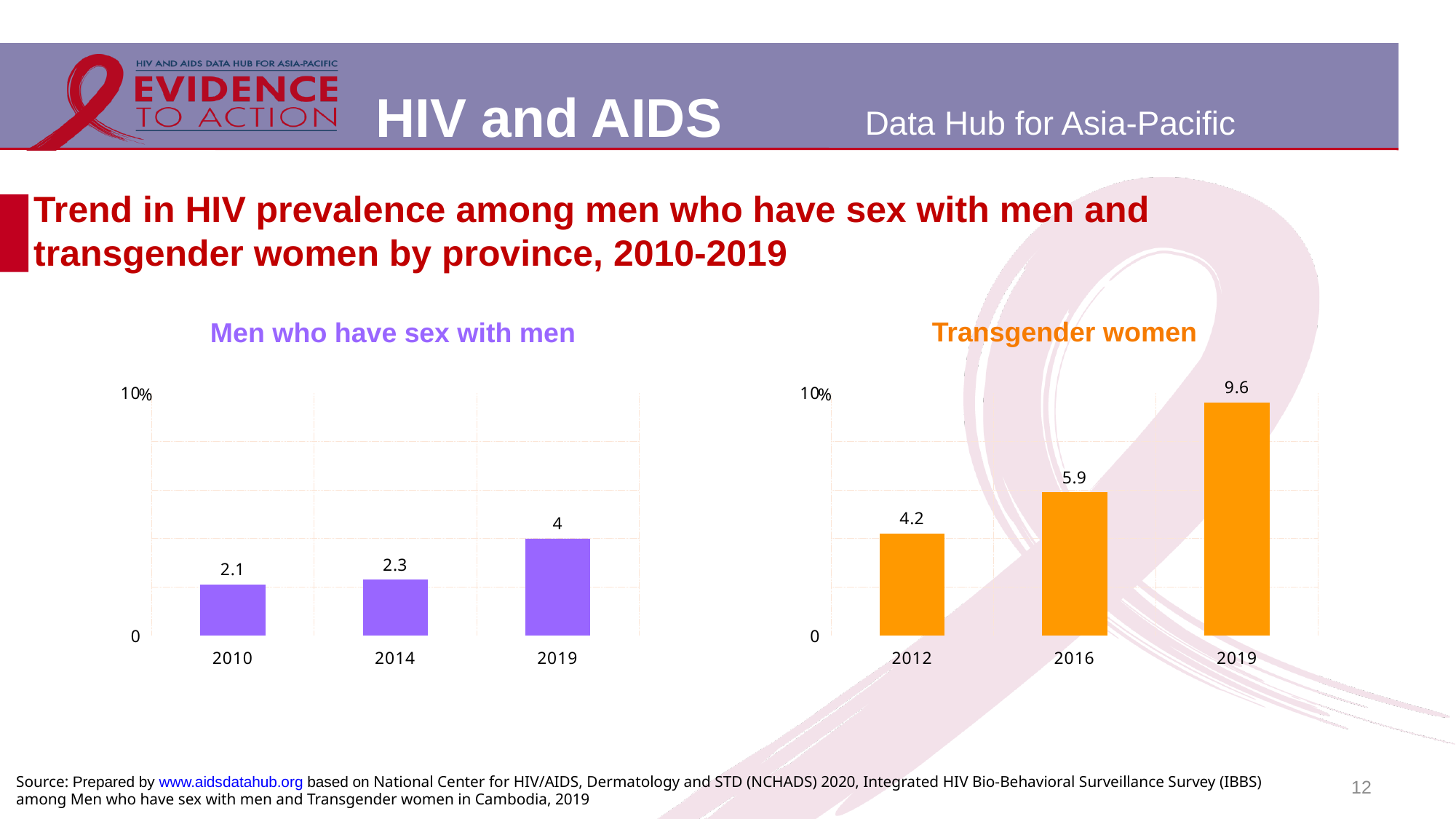
In the 'Transgender women' chart, what is the value for 2016? 5.9 In the 'Transgender women' chart, do the values rise or fall from 2012 to 2019? Rise What colour are the bars in the 'Transgender women' chart? Orange In the 'Transgender women' chart, which year has the highest value? 2019 Which is larger: the 2019 value in the 'Men who have sex with men' chart or the 2019 value in the 'Transgender women' chart? Transgender women In the 'Men who have sex with men' chart, what is the maximum value shown on the y axis? 10% In the 'Men who have sex with men' chart, how many years are shown on the x axis? 3 In the 'Men who have sex with men' chart, what is the value for 2014? 2.3 What kind of chart is the 'Transgender women' chart? Bar chart In the 'Men who have sex with men' chart, which year has the lowest value? 2010 In the 'Men who have sex with men' chart, what is the difference between the 2019 and 2010 values? 1.9 In the 'Transgender women' chart, what is the difference between the 2019 and 2012 values? 5.4